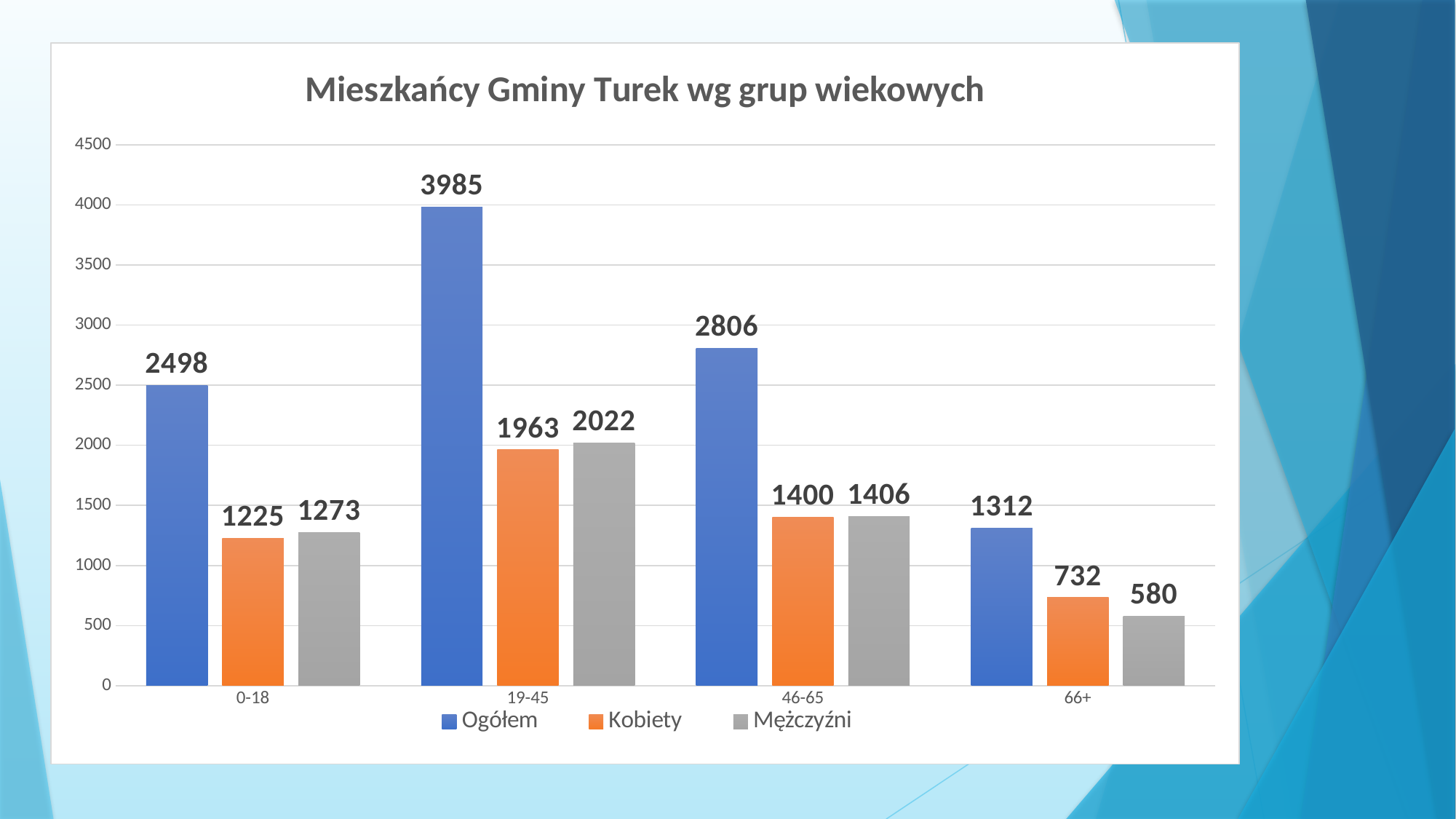
Which age group has the lowest Mężczyźni value? 66+ What is the title of the chart? Mieszkańcy Gminy Turek wg grup wiekowych What is the value of Mężczyźni for the 0-18 age group? 1273 Which age group has the highest Ogółem value? 19-45 How many age groups are shown on the x axis? 4 What is the value of Ogółem for the 19-45 age group? 3985 What kind of chart is shown on the slide? bar chart How many series does the legend list? 3 Which is larger in the 66+ age group, Kobiety or Mężczyźni? Kobiety Is the Ogółem value for the 46-65 age group greater or less than 2500? greater What is the value of Kobiety for the 66+ age group? 732 What is the difference between Mężczyźni and Kobiety in the 19-45 age group? 59